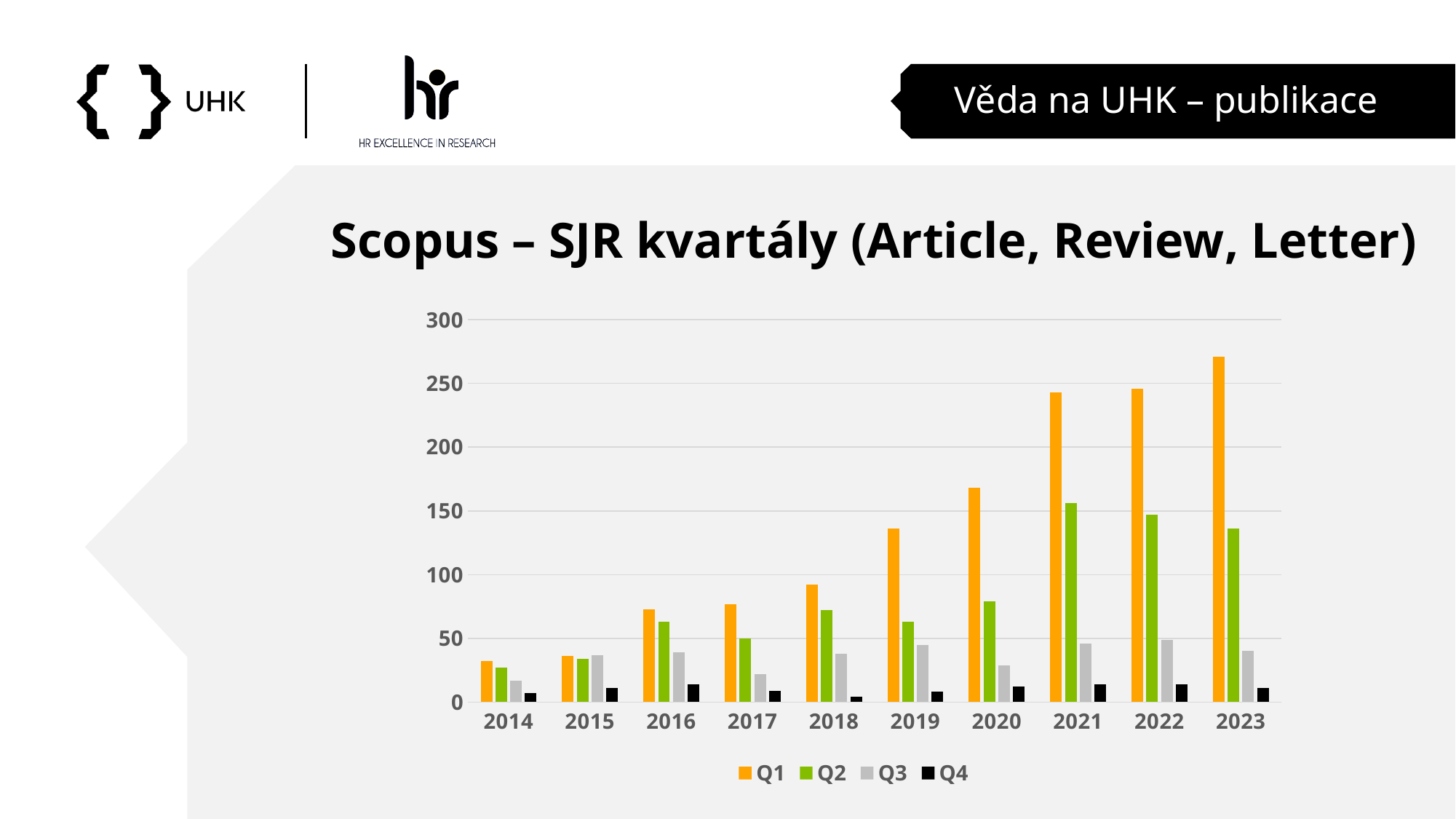
Which year has the lowest Q1 value? 2014 Is the Q3 value for 2014 greater or less than 50? less Which year has the larger Q2 value, 2016 or 2017? 2016 What kind of chart is shown on the slide? bar chart In 2023, which is larger, the Q1 value or the Q2 value? Q1 How many series does the chart's legend list? 4 Is the Q1 value for 2020 greater or less than 150? greater Is the Q2 value for 2021 greater or less than 100? greater Does the Q1 series generally rise or fall from 2014 to 2023? rise How many years are shown on the x axis of the chart? 10 Which year has the highest Q1 value? 2023